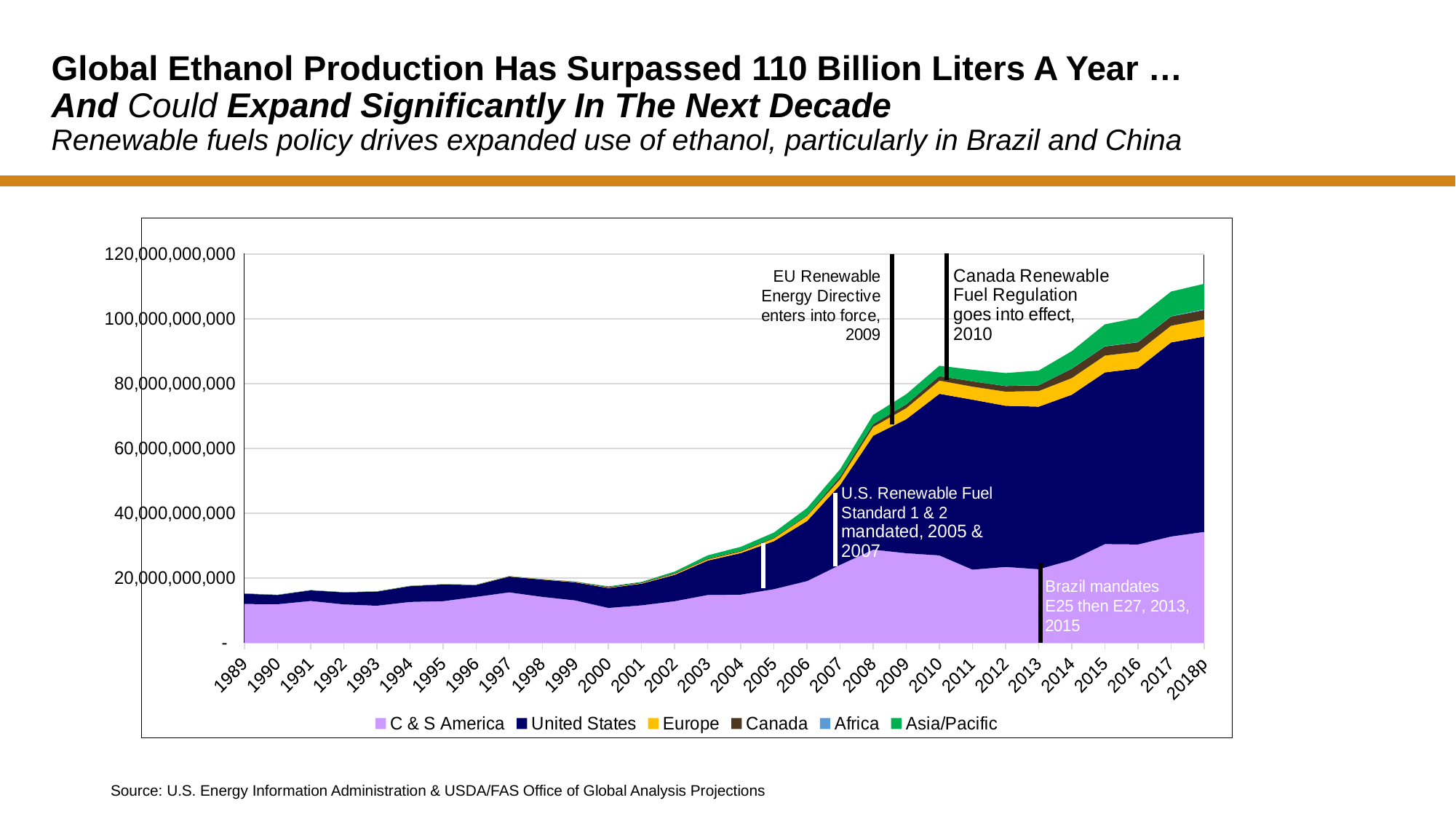
Is the total production in 1989 greater or less than 20,000,000,000? less What kind of chart is shown on the slide? Stacked area chart According to the annotation, in what year did the EU Renewable Energy Directive enter into force? 2009 Which is larger, the total production in 2008 or in 2010? 2010 Is the total production in 2018p greater or less than 100,000,000,000? greater Is the total production in 2008 greater or less than 60,000,000,000? greater Which series is plotted at the bottom of the stack? C & S America Does total global ethanol production rise or fall from 1989 to 2018p? Rise How many series does the legend list? 6 How many years are shown along the x axis? 30 Which year has the highest total production? 2018p